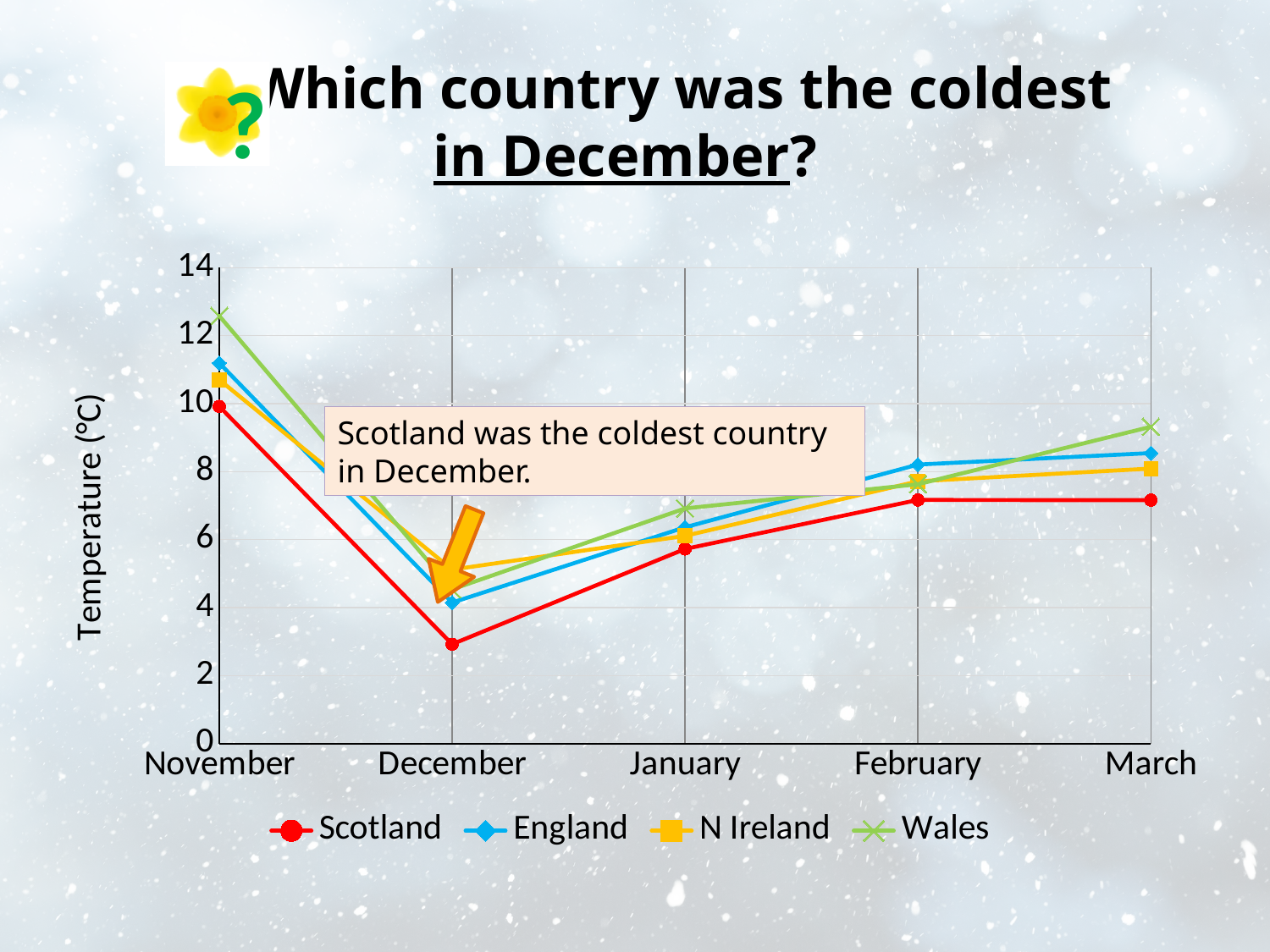
In December, which is higher: the temperature for Scotland or for England? England Which country has the lowest temperature in December? Scotland Is the temperature for Scotland in December greater or less than 4? less How many series does the legend list? 4 Is the temperature for England in March greater or less than 8? greater Which country has the highest temperature in November? Wales Which country has the highest temperature in March? Wales What kind of chart is shown on the slide? line chart How many months are shown along the x axis? 5 Is the temperature for Wales in November greater or less than 12? greater Does the temperature for Scotland rise or fall from November to December? fall What is the title of the vertical axis? Temperature (°C)